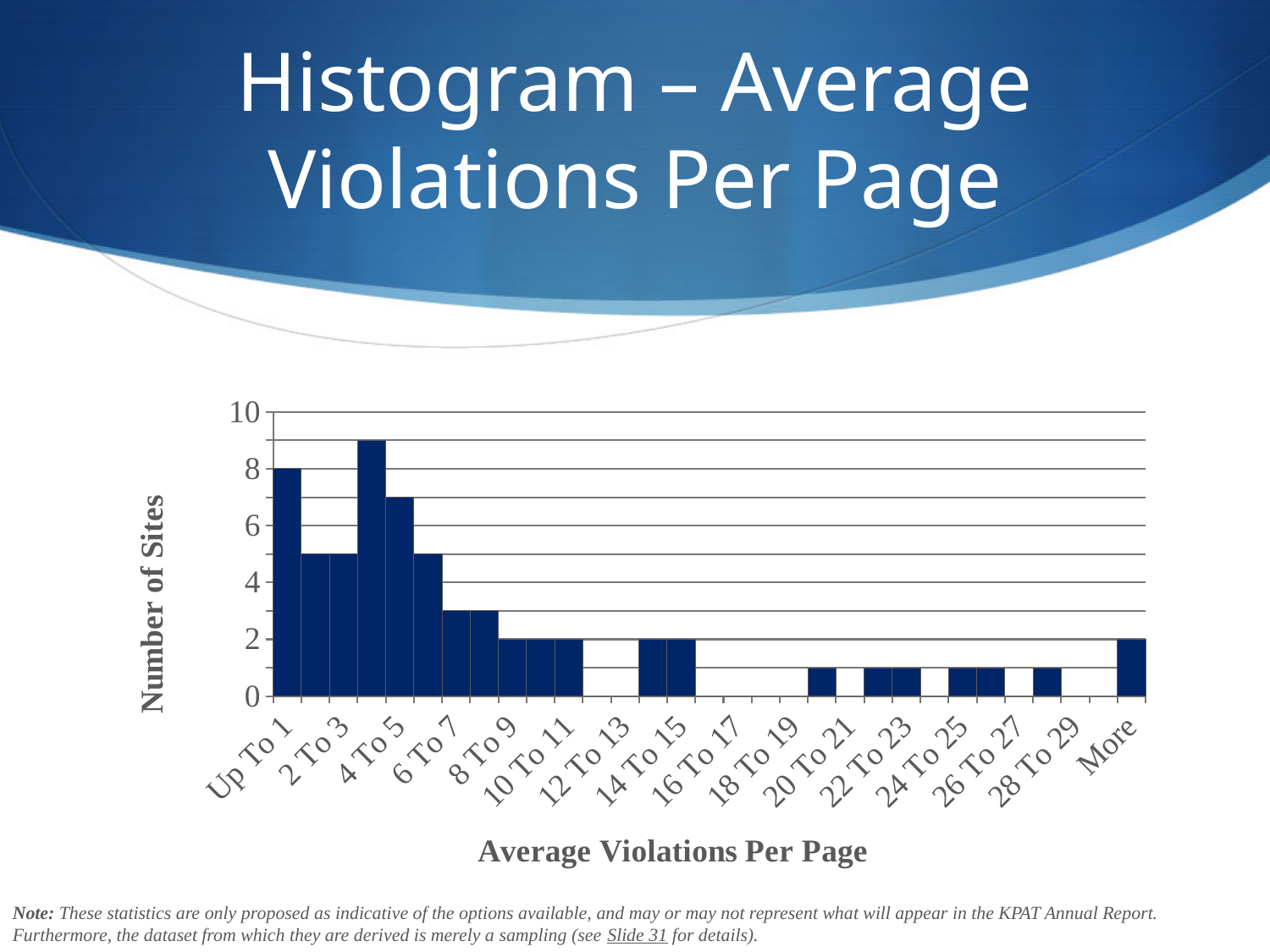
What is the number of sites for the '14 To 15' category? 2 What is the number of sites for the 'More' category? 2 What kind of chart is shown on the slide? bar chart Is the value for '4 To 5' greater or less than 6? greater What is the title of the vertical axis? Number of Sites What is the difference in number of sites between 'Up To 1' and 'More'? 6 Is the value for '22 To 23' greater or less than 2? less What is the number of sites for the 'Up To 1' category? 8 Do the values generally rise or fall moving from left to right along the x axis? fall Which has more sites, 'Up To 1' or '6 To 7'? Up To 1 Is the value for '6 To 7' greater or less than 4? less What is the number of sites for the '8 To 9' category? 2